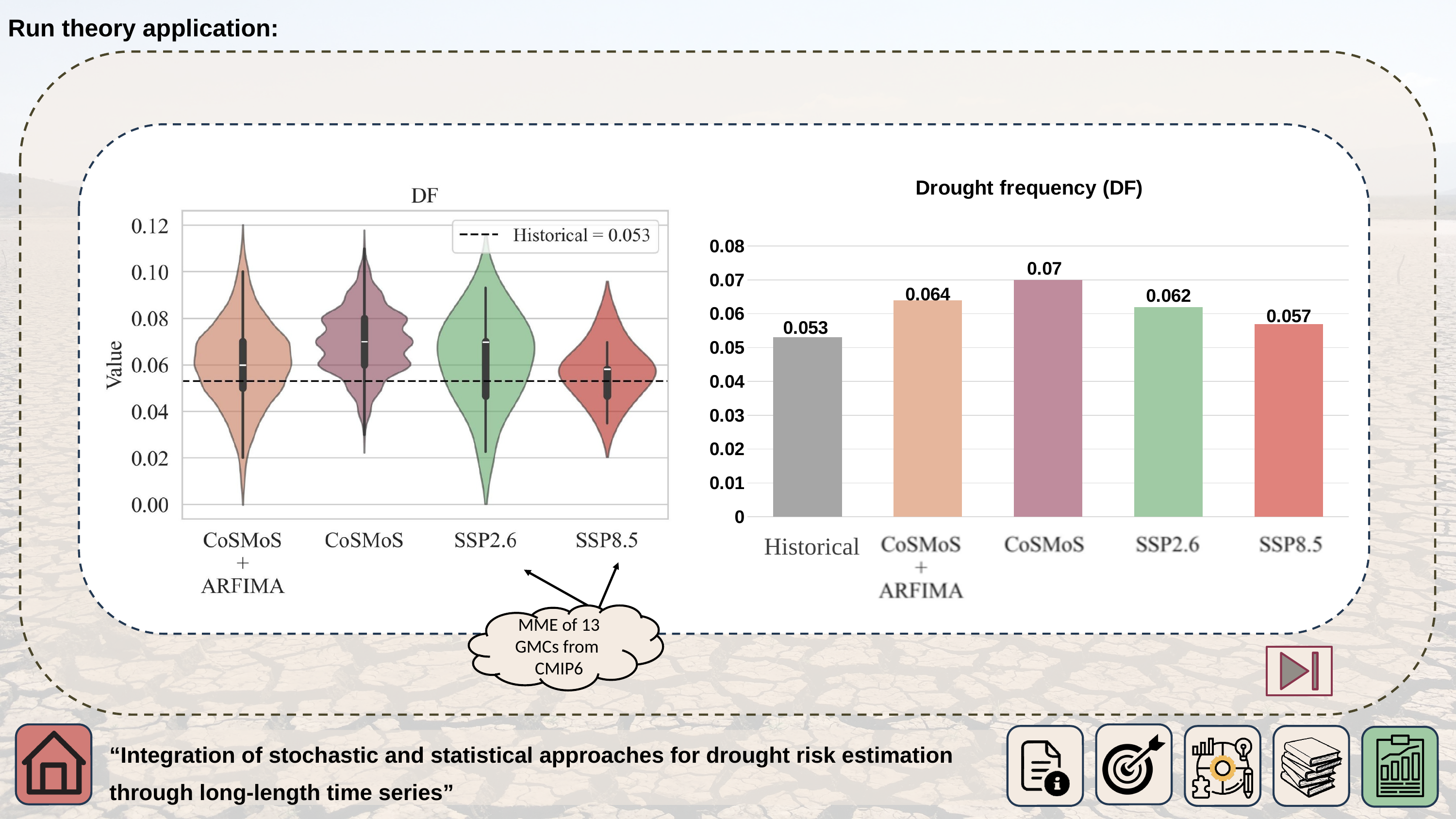
In the 'Drought frequency (DF)' bar chart, is the value for CoSMoS + ARFIMA greater or less than 0.06? greater What kind of chart is the chart titled 'Drought frequency (DF)' on the right of the slide? bar chart How many bars are shown in the 'Drought frequency (DF)' bar chart? 5 In the 'Drought frequency (DF)' bar chart, what is the value for SSP8.5? 0.057 In the 'Drought frequency (DF)' bar chart, which category has the highest value? CoSMoS In the 'Drought frequency (DF)' bar chart, what is the difference between the CoSMoS value and the Historical value? 0.017 In the 'Drought frequency (DF)' bar chart, what is the value for CoSMoS + ARFIMA? 0.064 In the 'DF' violin plot on the left, what Historical value does the dashed line in the legend represent? 0.053 In the 'DF' violin plot on the left, how many categories are shown on the x axis? 4 In the 'Drought frequency (DF)' bar chart, which is larger, the value for SSP2.6 or the value for SSP8.5? SSP2.6 In the 'Drought frequency (DF)' bar chart, which category has the lowest value? Historical In the 'Drought frequency (DF)' bar chart, what is the value for Historical? 0.053